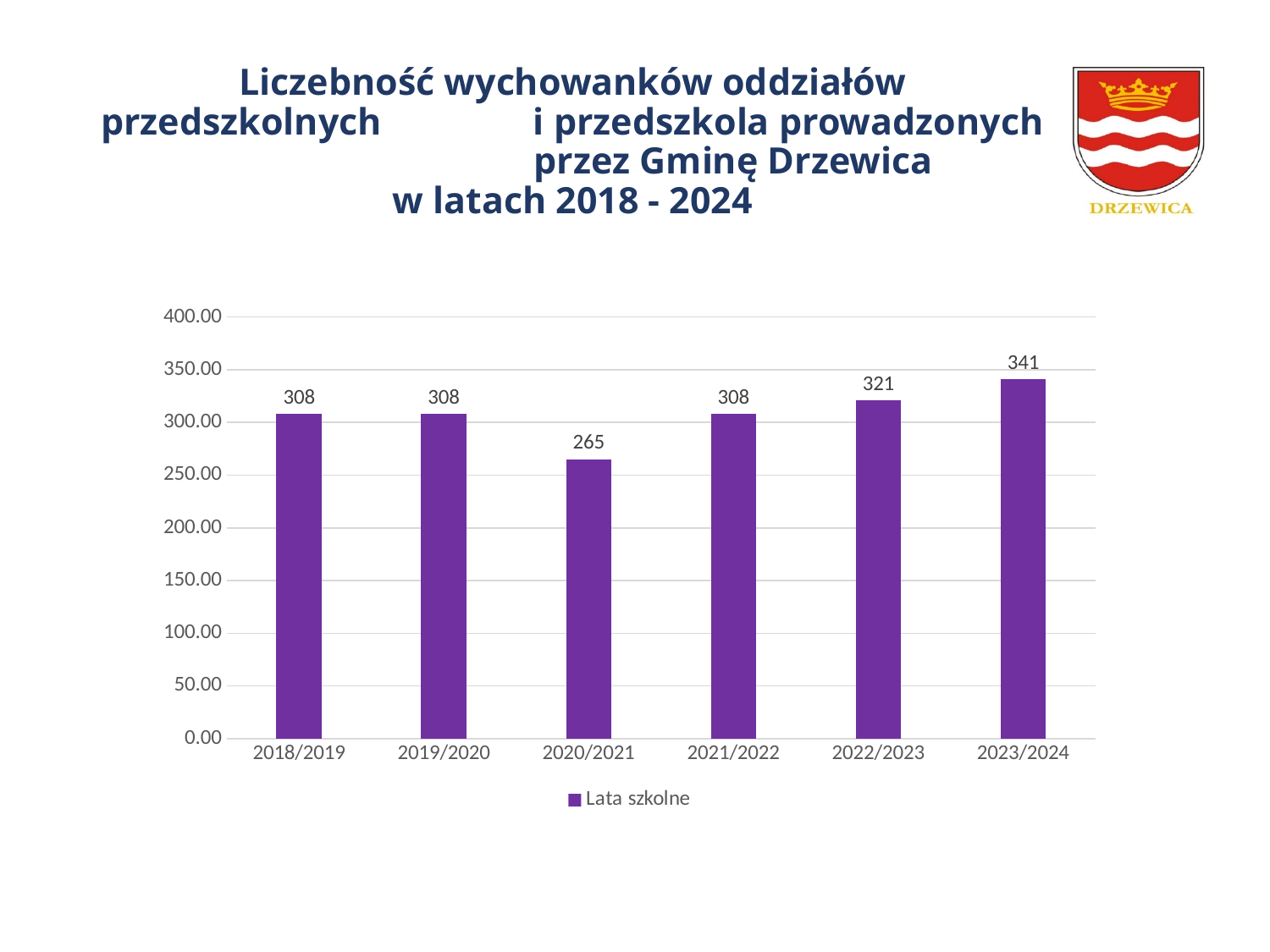
What is the difference between the values for 2023/2024 and 2020/2021? 76 What is the value for 2023/2024? 341 What is the value for 2022/2023? 321 Which school year has the highest value? 2023/2024 What is the value for 2020/2021? 265 How many school years are shown on the x axis? 6 Is the value for 2020/2021 greater or less than 300.00? less Which school year has the lowest value? 2020/2021 What is the difference between the values for 2022/2023 and 2021/2022? 13 What kind of chart is shown on the slide? bar chart Which is larger, the value for 2022/2023 or the value for 2020/2021? 2022/2023 What is the legend entry shown below the chart? Lata szkolne